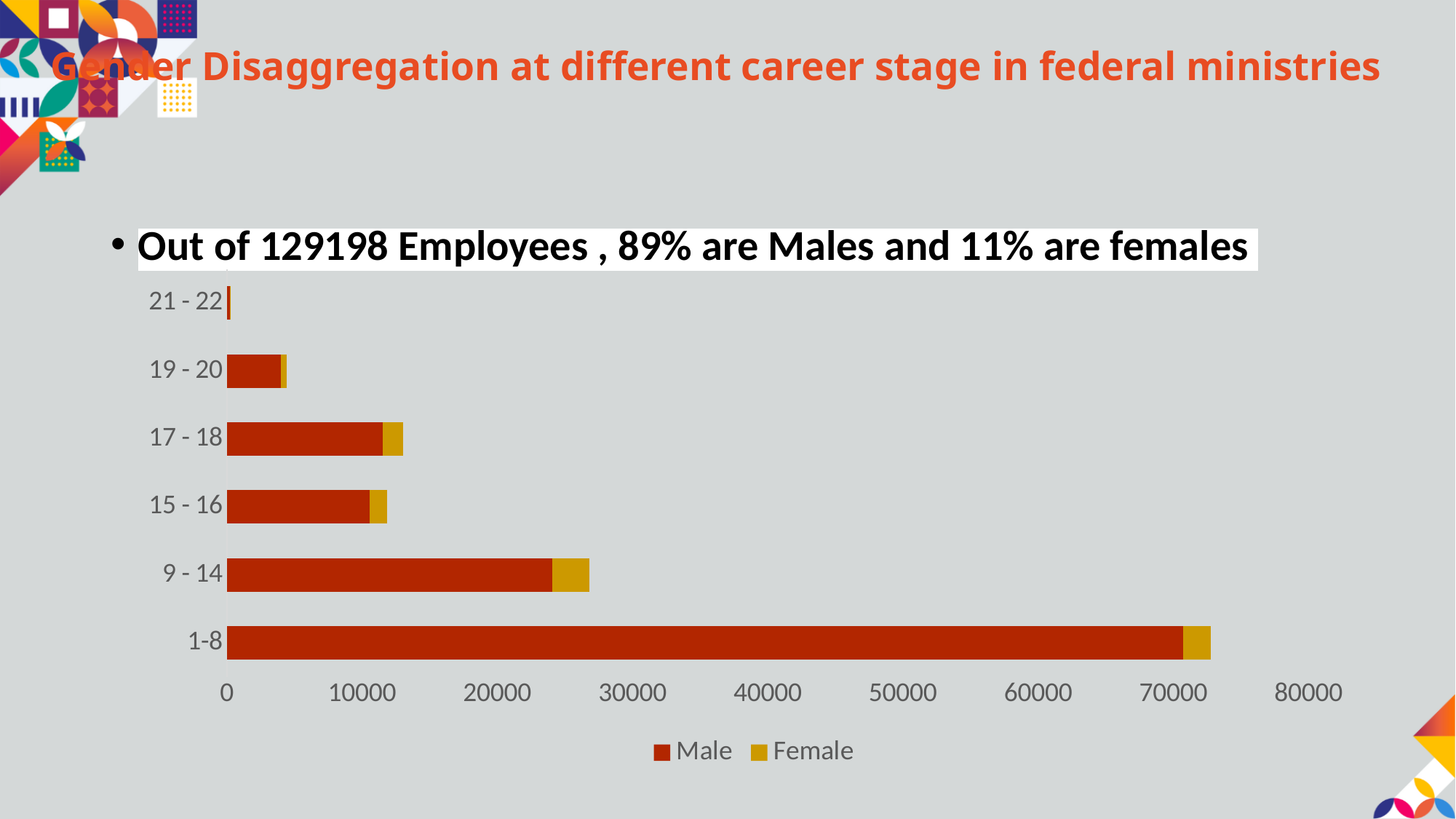
What kind of chart is shown on the slide? Stacked bar chart Is the Male value for 1-8 greater or less than 60000? greater What is the title of the slide containing the chart? Gender Disaggregation at different career stage in federal ministries Which category has the lowest Male value? 21 - 22 Is the Male value for 9 - 14 greater or less than 30000? less Which colour represents the Female series in the chart? Yellow How many career-stage categories are shown on the chart? 6 Is the Male value for 19 - 20 greater or less than 10000? less Which category has a larger Male value, 9 - 14 or 17 - 18? 9 - 14 How many series does the chart legend list? 2 Which category has the highest Male value? 1-8